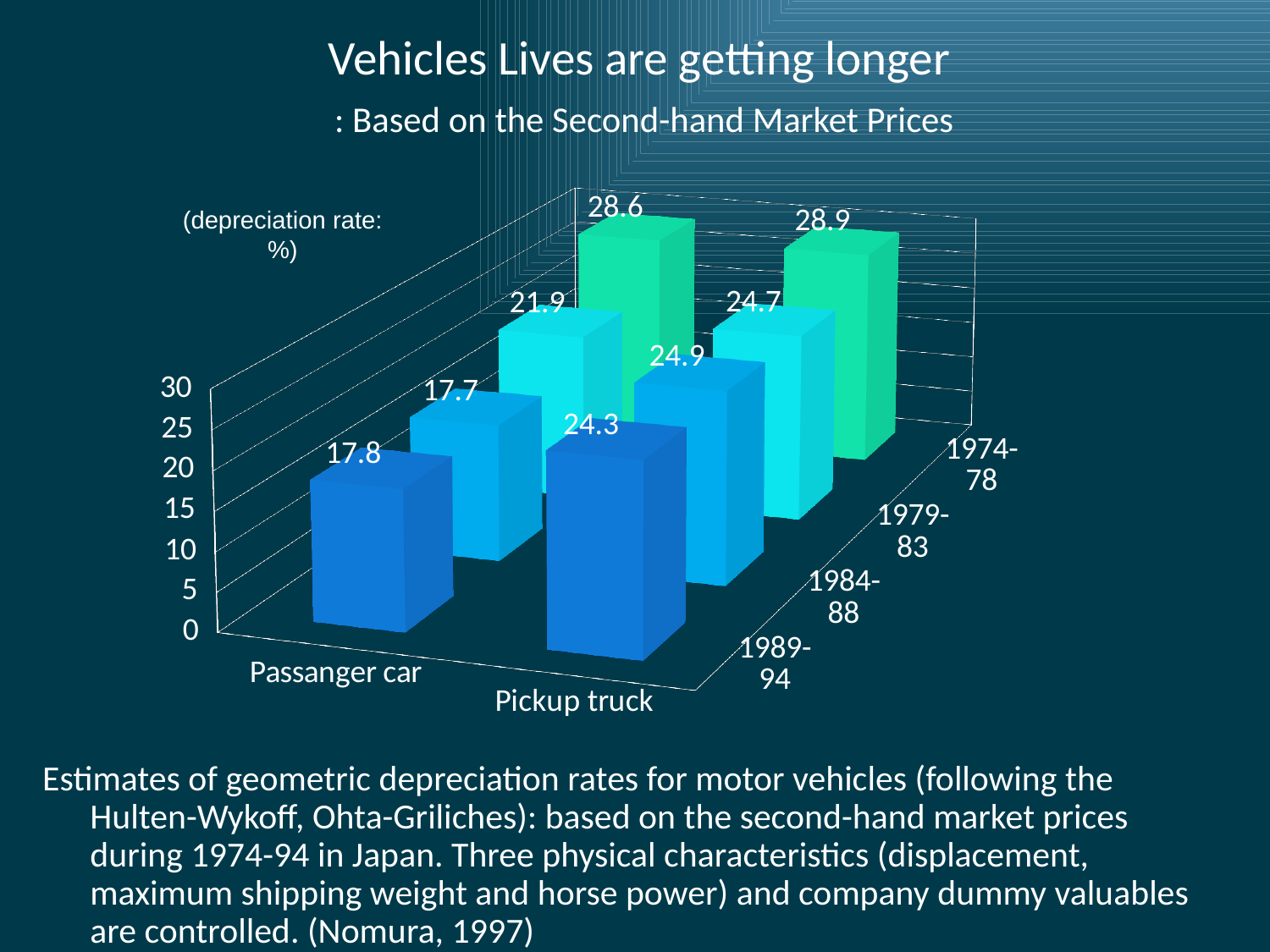
Does the depreciation rate for Passanger car rise or fall from 1974-78 to 1989-94? fall Which is larger in 1979-83, the depreciation rate for Passanger car or for Pickup truck? Pickup truck What is the depreciation rate for Passanger car in 1984-88? 17.7 What kind of chart is shown on the slide? 3D bar chart What is the depreciation rate for Pickup truck in 1979-83? 24.7 What unit is given for the values in the chart? depreciation rate: % How many time periods are shown on the depth axis of the chart? 4 What is the difference between the Passanger car depreciation rates in 1974-78 and 1989-94? 10.8 What is the depreciation rate for Pickup truck in 1989-94? 24.3 Which period has the lowest depreciation rate for Passanger car? 1984-88 What is the depreciation rate for Passanger car in 1974-78? 28.6 Which period has the highest depreciation rate for Pickup truck? 1974-78